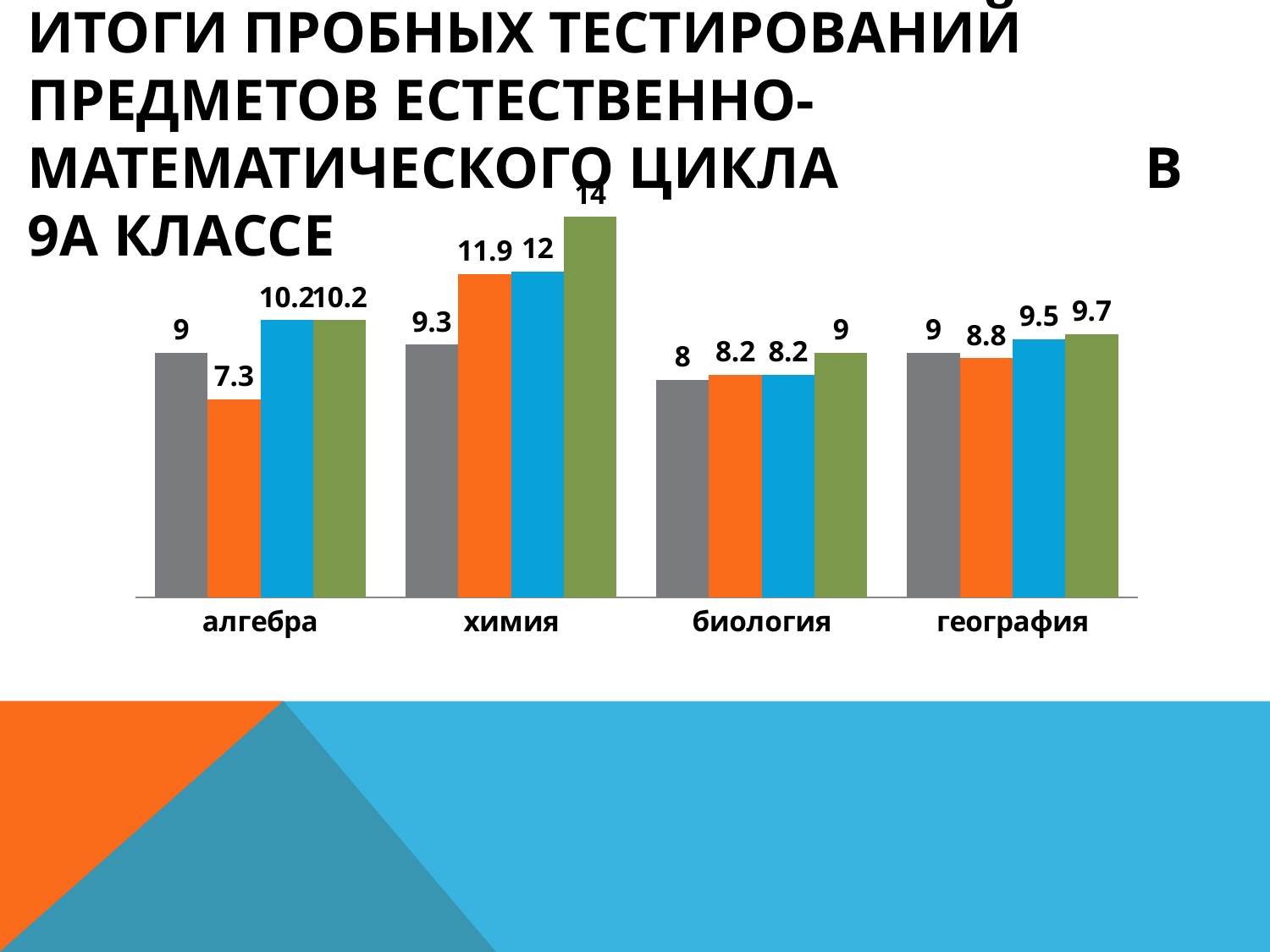
Which is larger: the orange bar for химия or the orange bar for география? the orange bar for химия What is the value of the orange bar for алгебра? 7.3 What are the category labels on the x axis, from left to right? алгебра, химия, биология, география Which category has the highest bar in the chart? химия What is the value of the blue bar for география? 9.5 How many bars are plotted for each category in the chart? 4 What is the difference between the green bar and the grey bar for химия? 4.7 What type of chart is shown on the slide? bar chart What is the value of the grey bar for биология? 8 Which bar is the lowest in the whole chart? the orange bar for алгебра (7.3) How many categories are shown on the x axis of the chart? 4 What is the value of the green bar for химия? 14